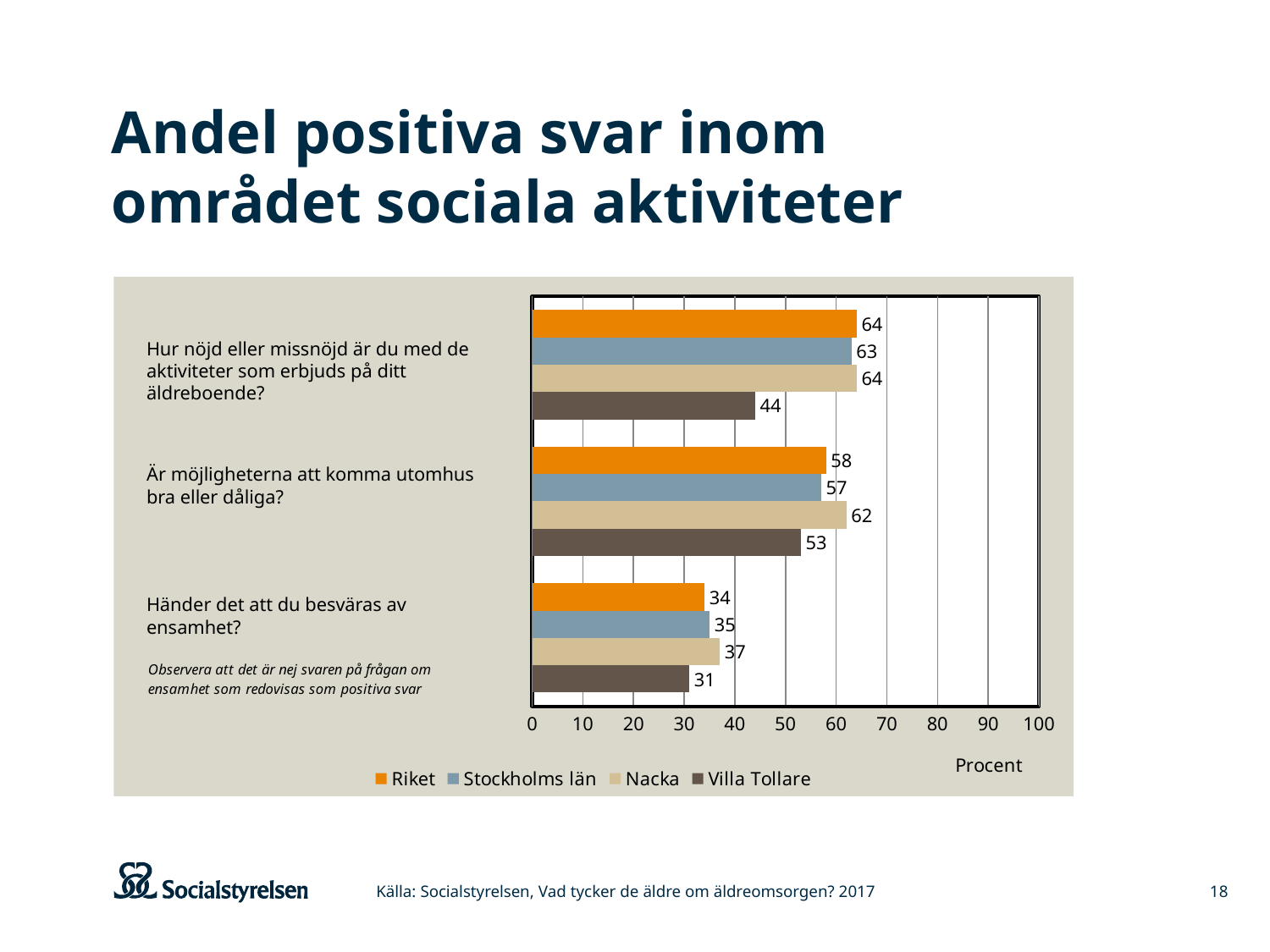
What is the value for Villa Tollare on the question "Hur nöjd eller missnöjd är du med de aktiviteter som erbjuds på ditt äldreboende?"? 44 What kind of chart is shown on the slide? Bar chart How many questions (categories) are shown on the chart? 3 What is the difference between the Riket value and the Villa Tollare value on the question "Hur nöjd eller missnöjd är du med de aktiviteter som erbjuds på ditt äldreboende?"? 20 Which is larger on the question "Är möjligheterna att komma utomhus bra eller dåliga?": the value for Nacka or the value for Villa Tollare? Nacka What unit is shown on the horizontal axis of the chart? Procent Which series has the highest value on the question "Är möjligheterna att komma utomhus bra eller dåliga?"? Nacka How many series does the legend list? 4 What is the value for Nacka on the question "Är möjligheterna att komma utomhus bra eller dåliga?"? 62 Which series has the lowest value on the question "Händer det att du besväras av ensamhet?"? Villa Tollare What is the value for Stockholms län on the question "Händer det att du besväras av ensamhet?"? 35 What is the value for Riket on the question "Är möjligheterna att komma utomhus bra eller dåliga?"? 58